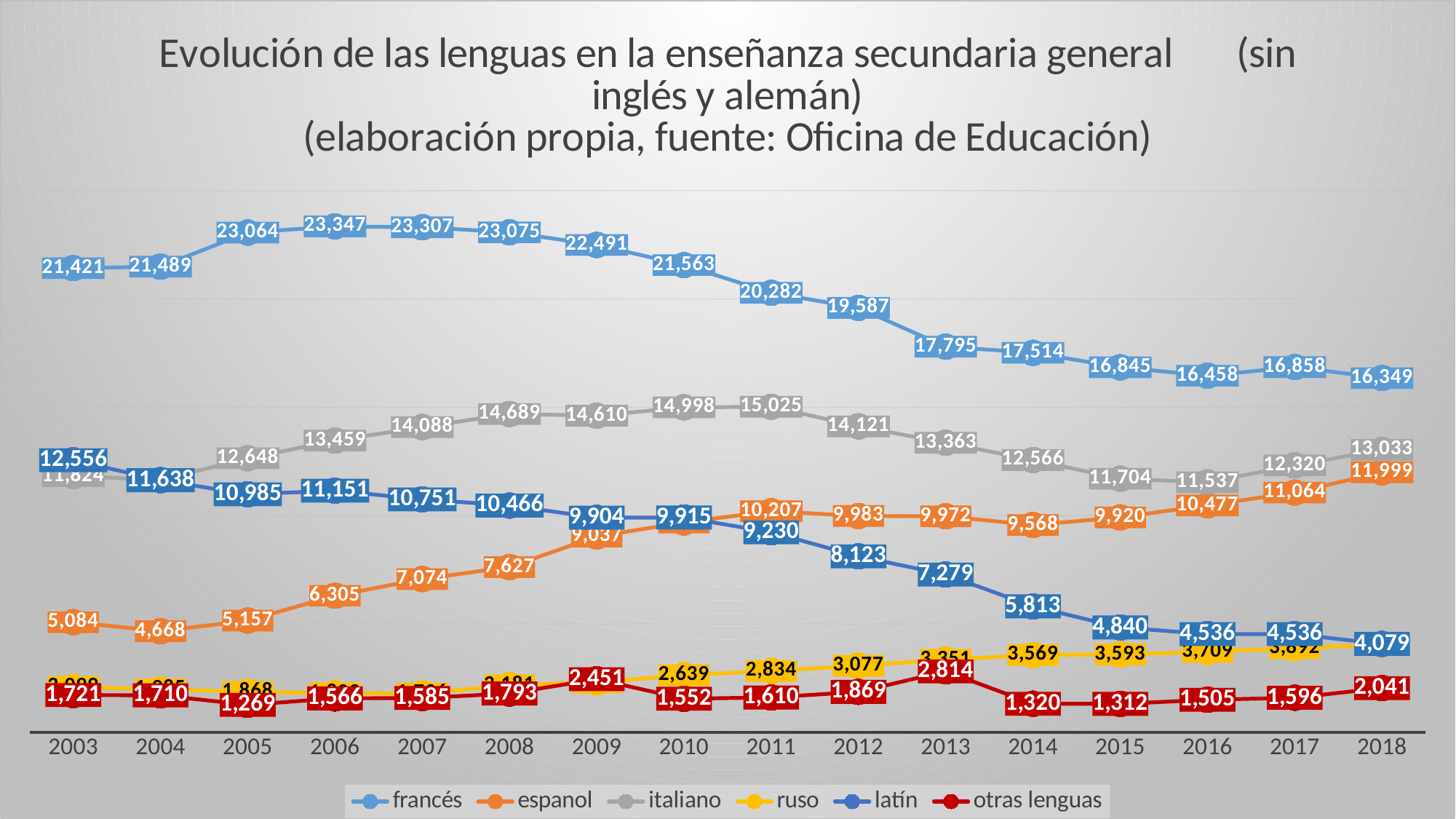
In which year does latín reach its lowest value? 2018 What is the value for otras lenguas in 2013? 2,814 Which is larger in 2018, the value for espanol or the value for italiano? italiano How many years are plotted along the x axis? 16 What is the difference between the francés values in 2003 and 2018? 5,072 In which year does francés reach its highest value? 2006 How many series does the legend list? 6 What is the value for francés in 2006? 23,347 What kind of chart is shown on the slide? line chart What is the value for italiano in 2011? 15,025 What is the value for latín in 2018? 4,079 Does the latín series rise or fall from 2003 to 2018? fall